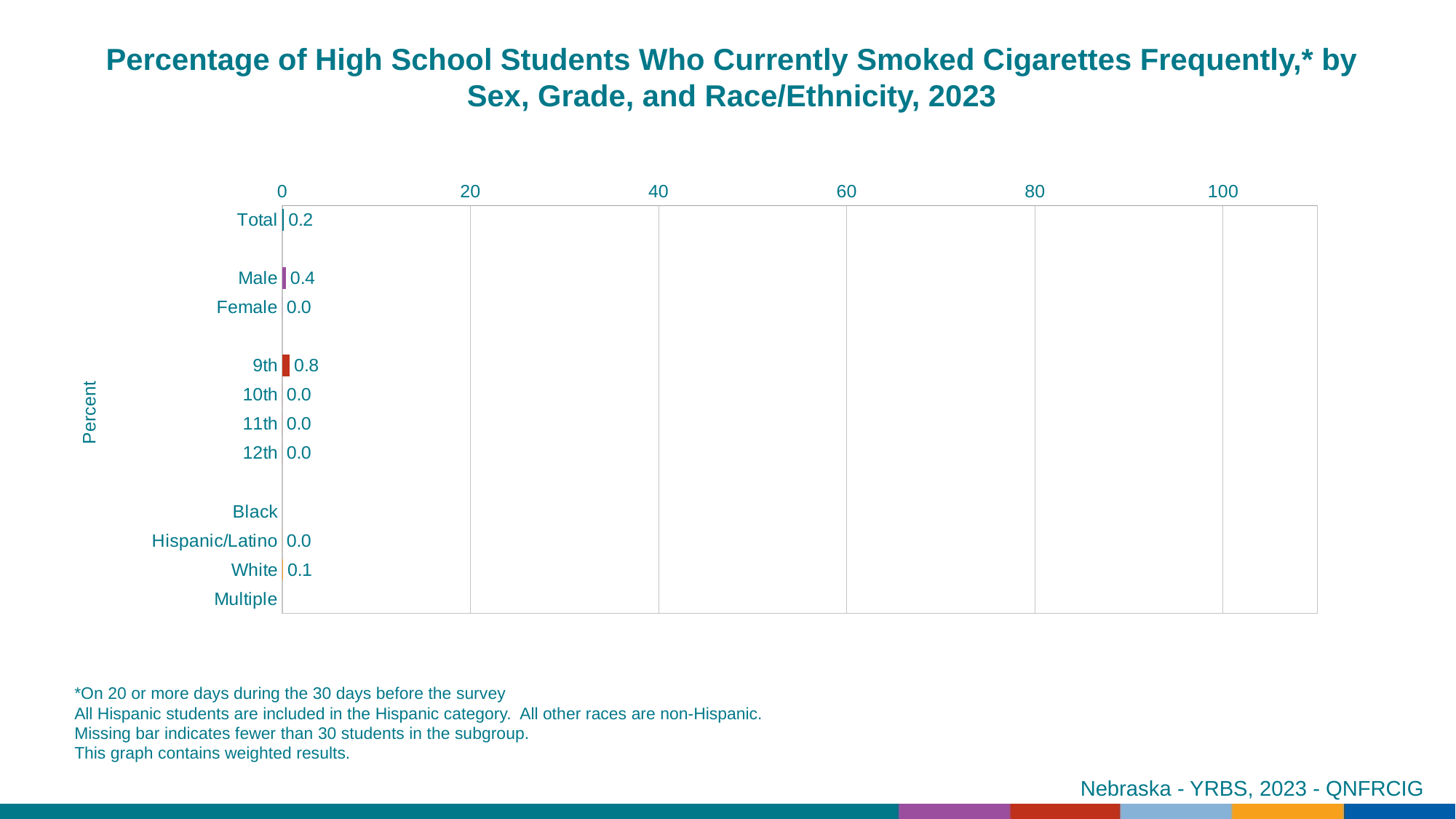
What kind of chart is shown on the slide? bar chart Is the value for 9th grade greater or less than 20? less Which category has the highest value? 9th What is the value for 9th grade? 0.8 What is the difference between the values for Male and Female? 0.4 What is the value for Male? 0.4 What is the value for Female? 0.0 What is the value for Total? 0.2 What is the difference between the values for 9th grade and Total? 0.6 What is the value for White? 0.1 Which is larger, the value for Male or the value for White? Male Which two categories have no bar shown, indicating fewer than 30 students in the subgroup? Black and Multiple